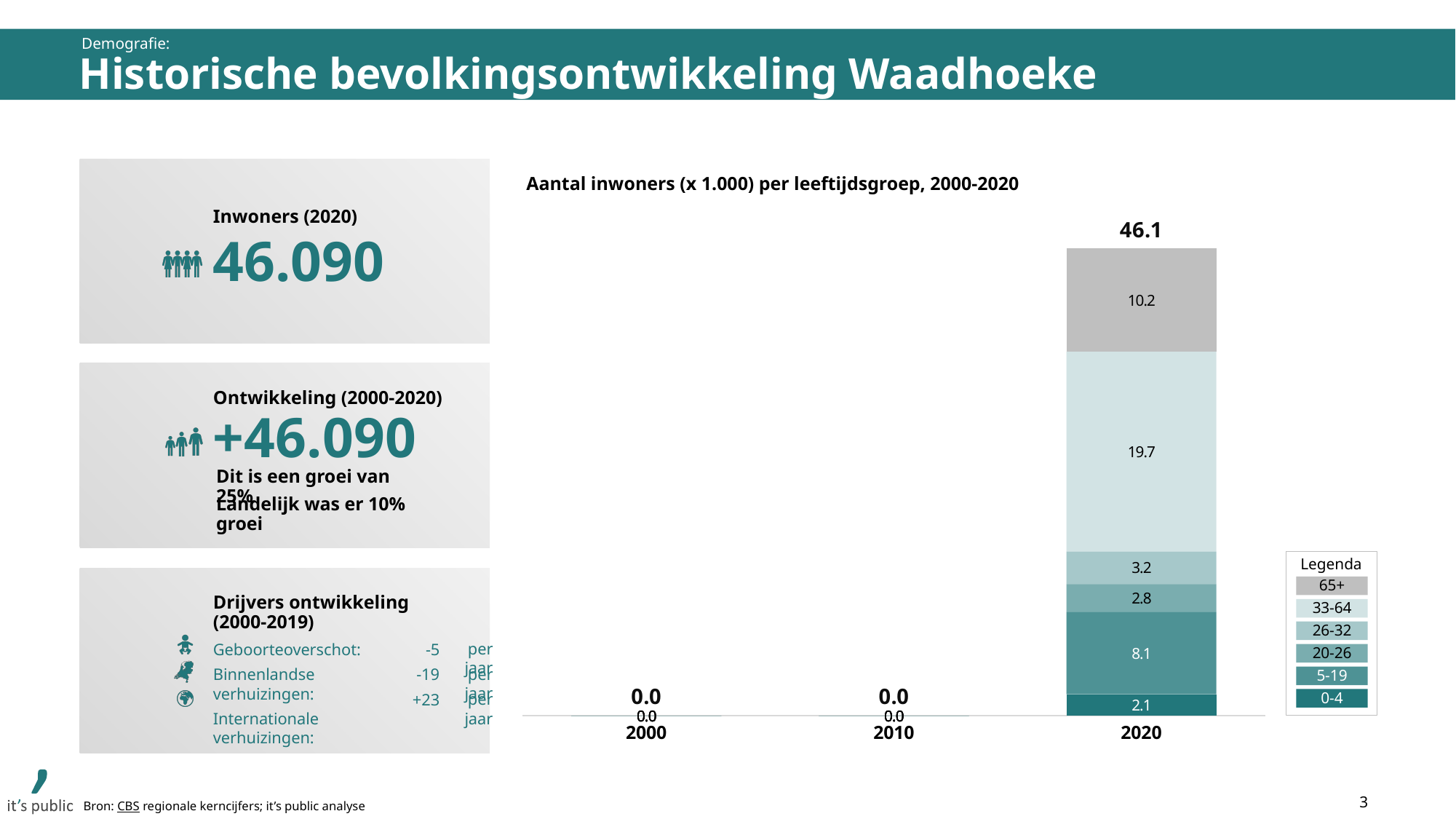
What type of chart is used to show the number of inhabitants per age group? Stacked bar chart Which age group has the largest value in the 2020 bar? 33-64 What is the difference between the 33-64 and 65+ values in 2020? 9.5 How many years are shown on the x axis of the chart? 3 In 2020, which is larger: the 26-32 group or the 20-26 group? 26-32 Which age group has the smallest value in the 2020 bar? 0-4 What value is shown for the 0-4 age group in 2020? 2.1 How many age groups does the legend list? 6 What value is shown for the 5-19 age group in 2020? 8.1 What is the total number of inhabitants (x 1.000) shown for 2020 in the chart? 46.1 What value is shown for the 65+ age group in 2020? 10.2 What value is shown for the 33-64 age group in 2020? 19.7